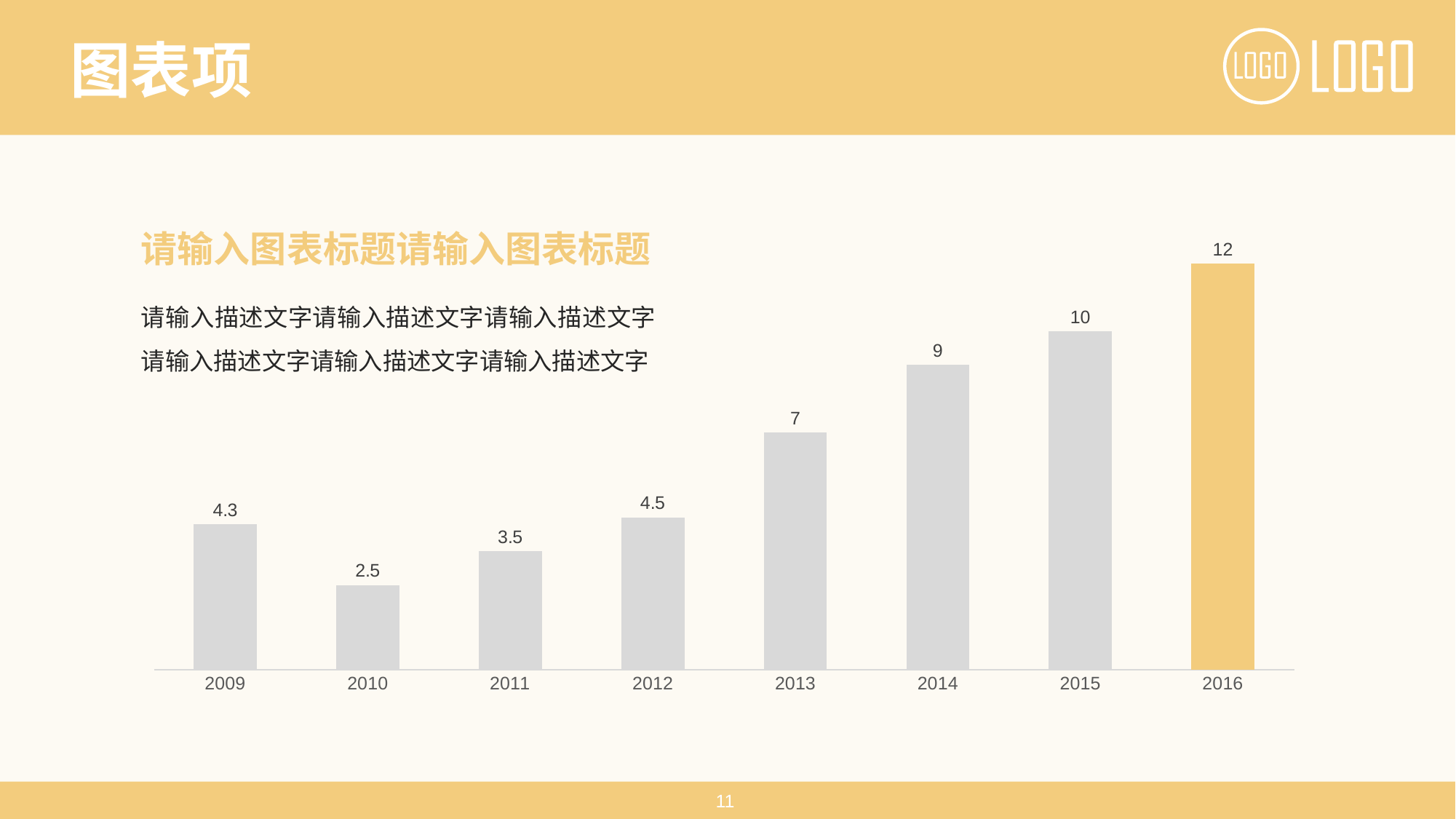
Which bar is highlighted in a different colour from the others? 2016 Which is larger, the value for 2011 or the value for 2012? 2012 What is the difference between the values for 2009 and 2010? 1.8 What is the value for 2009? 4.3 How many years are shown on the x axis? 8 What is the value for 2012? 4.5 Which year has the highest value? 2016 Which year has the lowest value? 2010 Do the values generally rise or fall from 2011 to 2016? rise What kind of chart is shown on the slide? bar chart What is the difference between the values for 2016 and 2015? 2 What is the value for 2015? 10